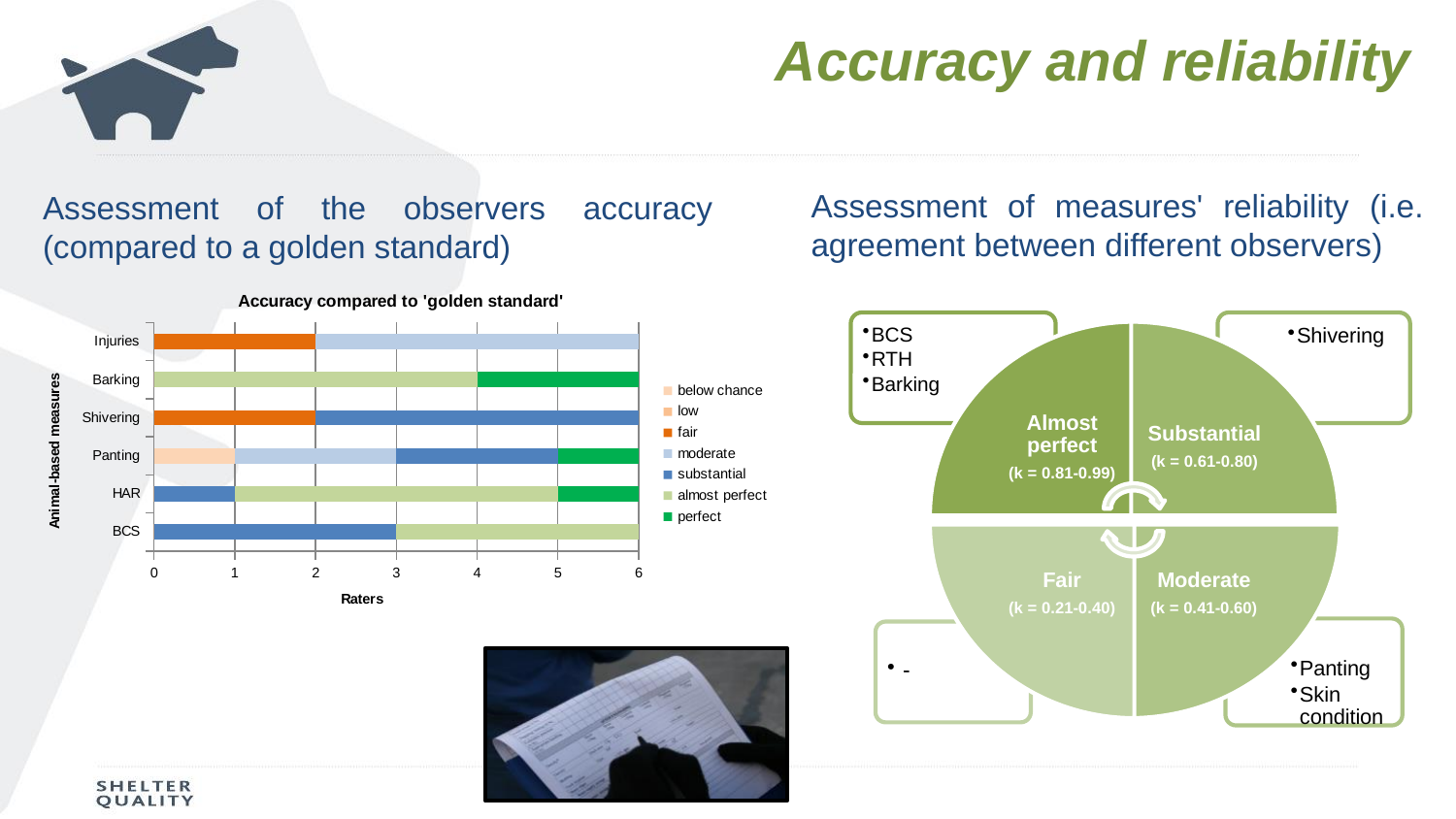
In the 'Accuracy compared to "golden standard"' chart, how many raters were rated 'fair' for Injuries? 2 In the 'Accuracy compared to "golden standard"' chart, is the 'almost perfect' segment for HAR greater or less than 3 raters? greater What is the y-axis label of the 'Accuracy compared to "golden standard"' chart? Animal-based measures In the 'Accuracy compared to "golden standard"' chart, how many raters were rated 'below chance' for Panting? 1 In the 'Accuracy compared to "golden standard"' chart, how many raters were rated 'fair' for Shivering? 2 How many animal-based measures are listed on the y axis of the 'Accuracy compared to "golden standard"' chart? 6 How many series does the legend of the 'Accuracy compared to "golden standard"' chart list? 7 In the 'Accuracy compared to "golden standard"' chart, what is the total number of raters for the Injuries bar? 6 What kind of chart is 'Accuracy compared to "golden standard"'? bar chart In the 'Accuracy compared to "golden standard"' chart, how many raters were rated 'almost perfect' for Barking? 4 In the 'Accuracy compared to "golden standard"' chart, how many raters were rated 'substantial' for BCS? 3 What is the x-axis label of the 'Accuracy compared to "golden standard"' chart? Raters